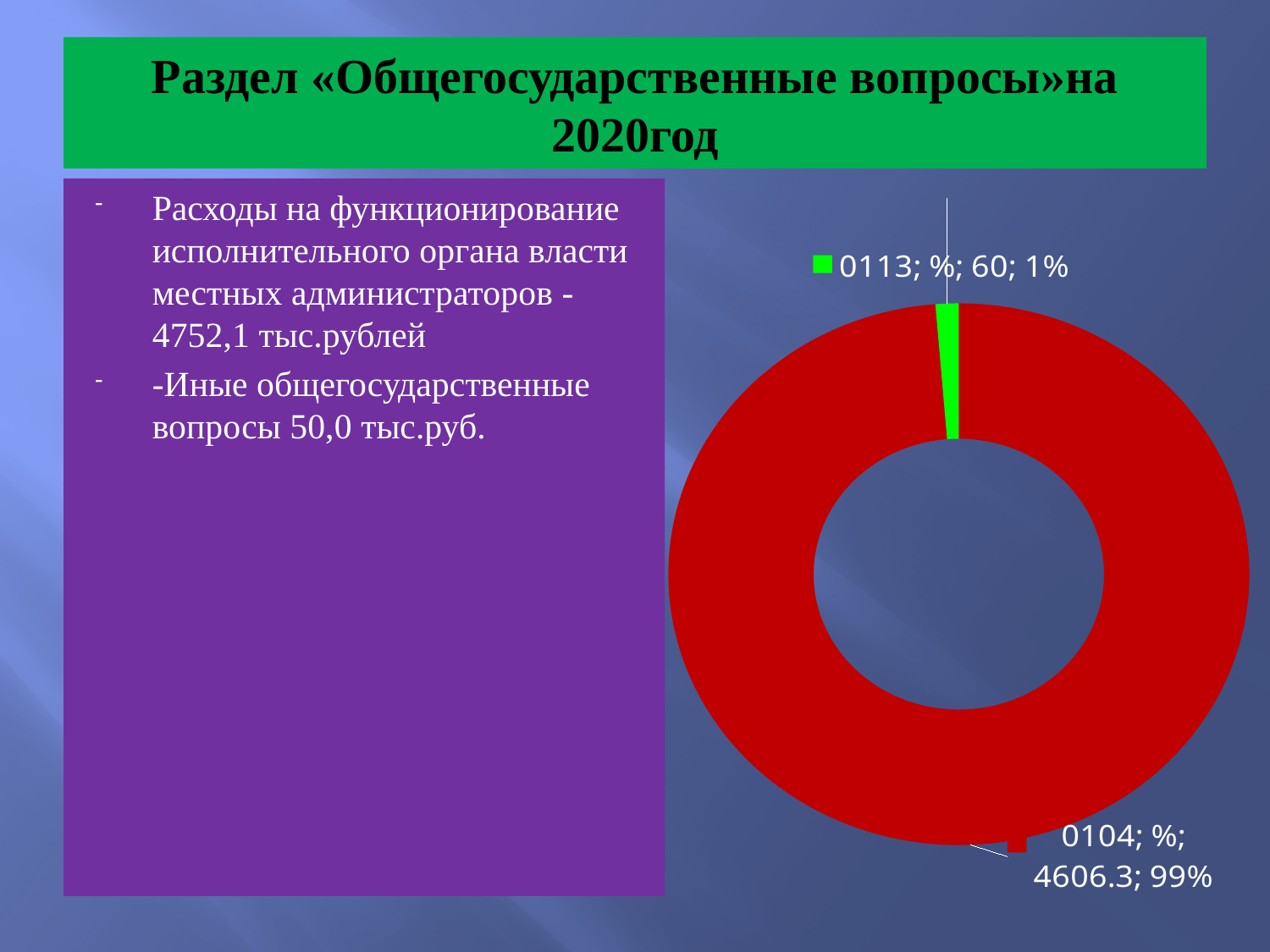
What is the difference between the values for 0104 and 0113? 4546.3 What is the value shown for the 0104 slice? 4606.3 What colour is the 0113 slice? green What colour is the 0104 slice? red Which slice is the largest? 0104 How many slices does the chart have? 2 What is the value shown for the 0113 slice? 60 Which is larger, the value for 0104 or the value for 0113? 0104 What share of the chart does the 0113 slice represent? 1% Which slice is the smallest? 0113 What kind of chart is shown on the slide? doughnut chart What share of the chart does the 0104 slice represent? 99%